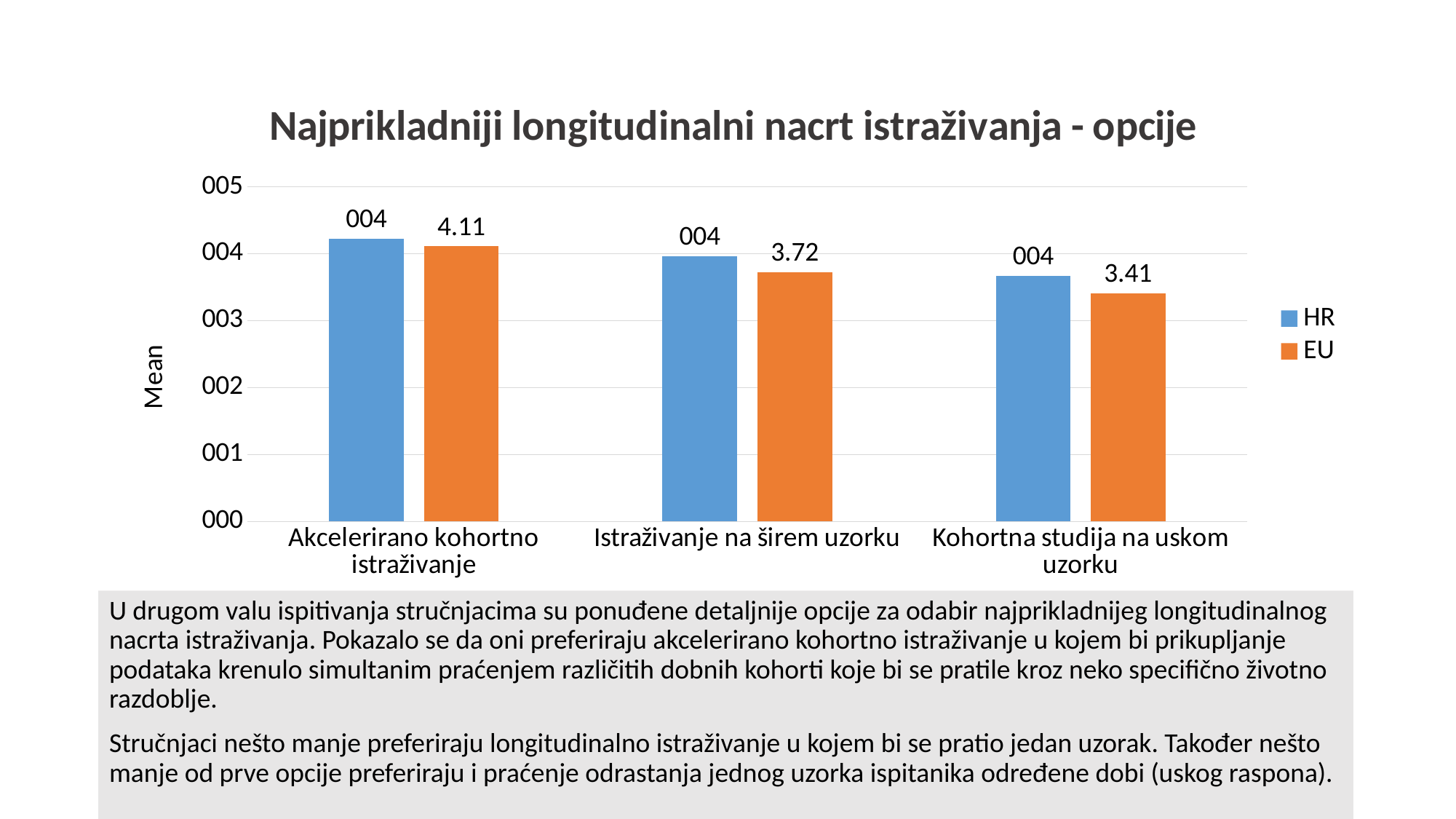
What is the title of the chart? Najprikladniji longitudinalni nacrt istraživanja - opcije What type of chart is shown on the slide? bar chart How many series does the legend list? 2 What is the EU value for Kohortna studija na uskom uzorku? 3.41 How many categories are shown on the x axis? 3 What is the EU value for Akcelerirano kohortno istraživanje? 4.11 What is the EU value for Istraživanje na širem uzorku? 3.72 For Istraživanje na širem uzorku, which is larger, the HR value or the EU value? HR Which category has the lowest EU value? Kohortna studija na uskom uzorku Which category has the highest EU value? Akcelerirano kohortno istraživanje What is the difference between the EU values for Akcelerirano kohortno istraživanje and Kohortna studija na uskom uzorku? 0.70